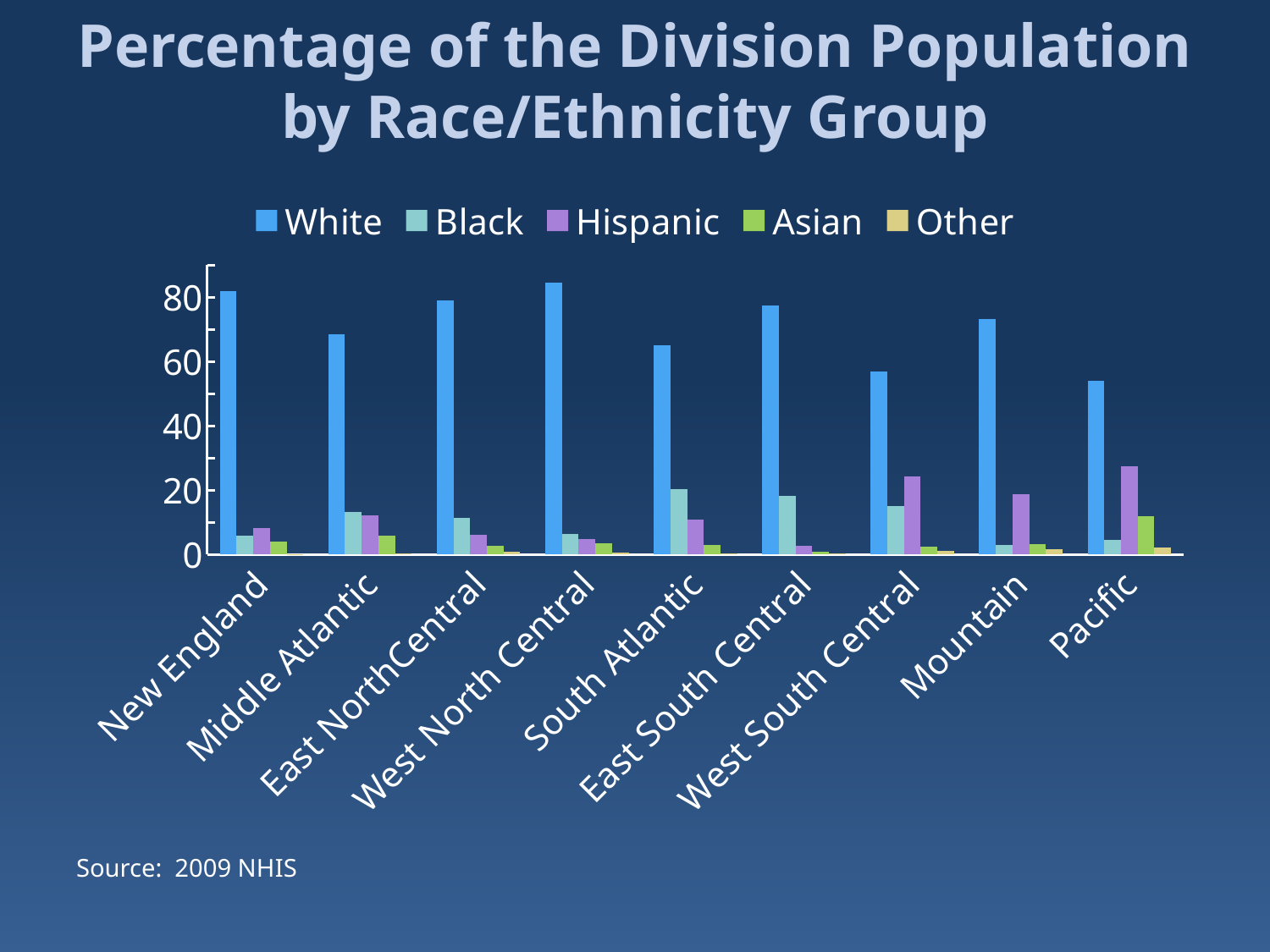
Which is larger, the White value for New England or the White value for Pacific? New England Is the Hispanic value for West South Central greater or less than 20? greater Is the White value for Pacific greater or less than 60? less Is the White value for Middle Atlantic greater or less than 80? less What is the title of the chart? Percentage of the Division Population by Race/Ethnicity Group Which division has the highest Asian percentage? Pacific How many series does the legend list? 5 How many divisions are shown on the x axis? 9 In South Atlantic, which is larger, the Black value or the Hispanic value? Black What kind of chart is shown on the slide? bar chart